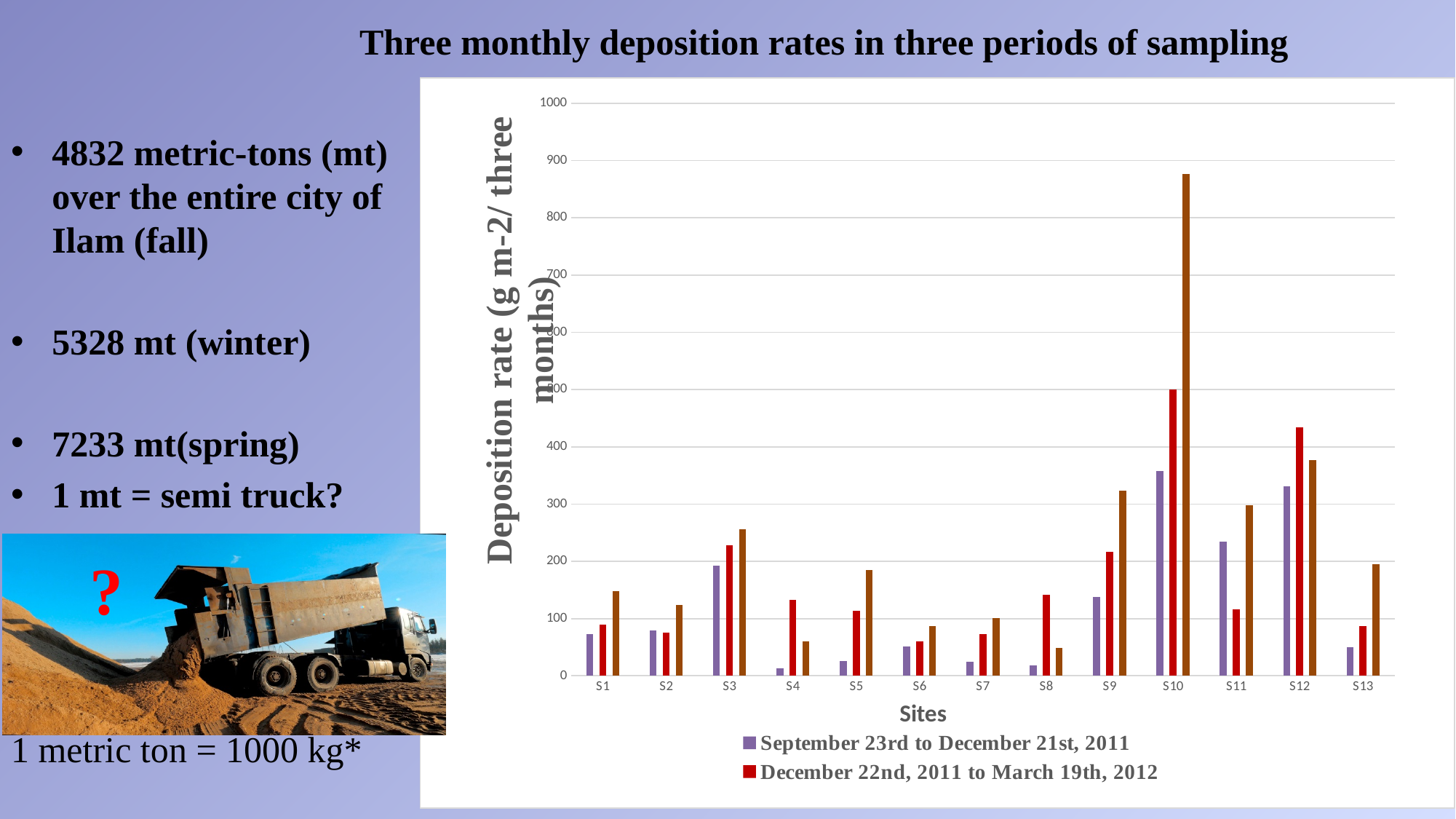
Is the value for S3 in the September 23rd to December 21st, 2011 series greater or less than 100? greater What is the title of the x axis of the chart? Sites Is the value for S10 in the December 22nd, 2011 to March 19th, 2012 series greater or less than 400? greater Which site has the higher value in the September 23rd to December 21st, 2011 series, S11 or S12? S12 Which site has the highest value in the December 22nd, 2011 to March 19th, 2012 series? S10 Which site has the tallest bar in the chart? S10 Which site has the higher value in the December 22nd, 2011 to March 19th, 2012 series, S8 or S9? S9 Is the value for S4 in the December 22nd, 2011 to March 19th, 2012 series greater or less than 100? greater What type of chart is shown on the slide? bar chart How many sites are shown on the x axis of the chart? 13